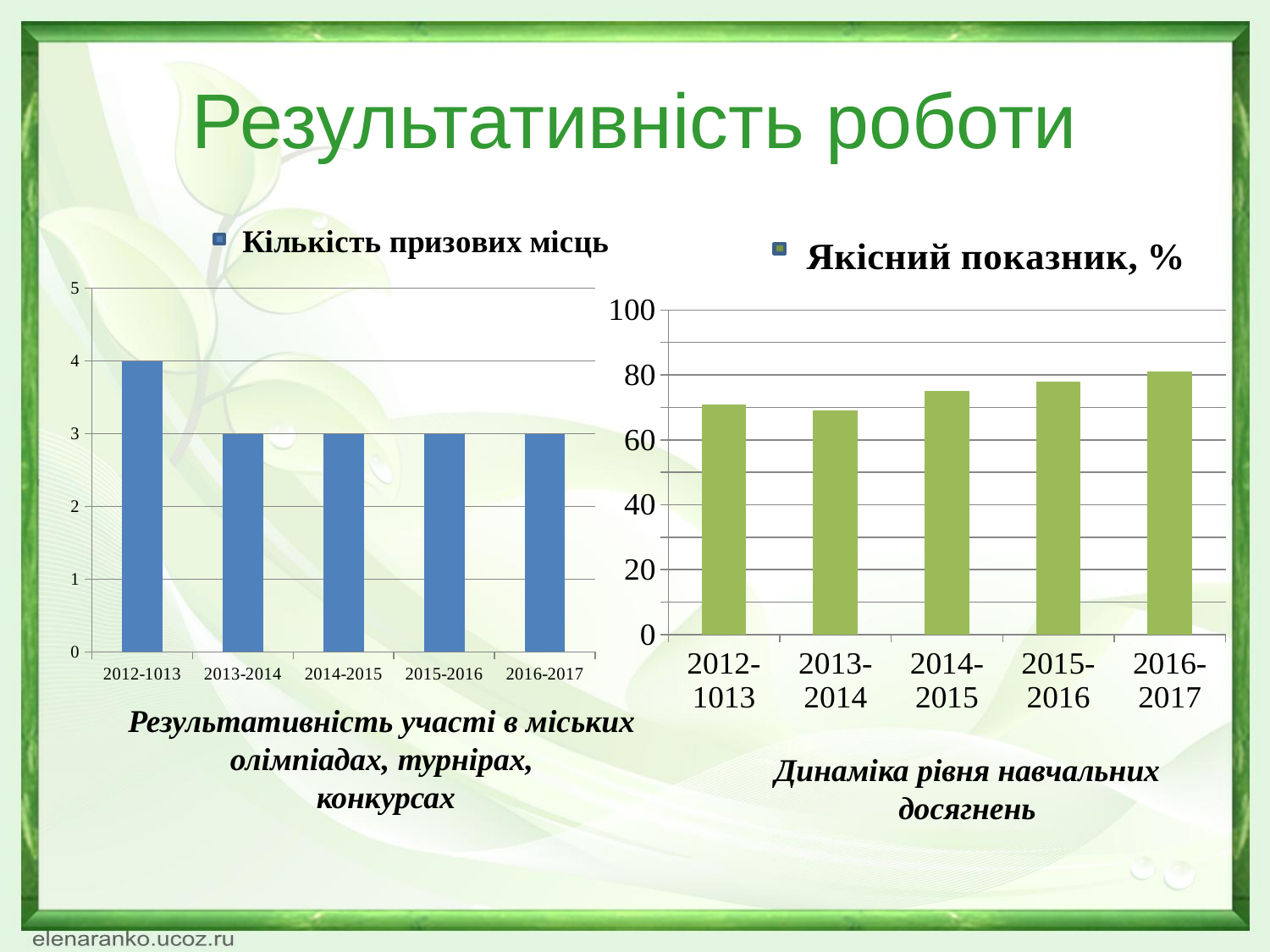
On the left chart (Кількість призових місць), what is the difference between the values for 2012-1013 and 2013-2014? 1 On the left chart (Кількість призових місць), what is the value for 2012-1013? 4 On the right chart (Якісний показник, %), which category has the highest value? 2016-2017 What type of chart is the left chart (Кількість призових місць)? bar chart What is the caption written below the right chart? Динаміка рівня навчальних досягнень On the right chart (Якісний показник, %), how many series does the legend list? 1 On the right chart (Якісний показник, %), is the value for 2012-1013 greater or less than 60? greater On the left chart (Кількість призових місць), what is the value for 2015-2016? 3 On the right chart (Якісний показник, %), which is larger, the value for 2013-2014 or the value for 2014-2015? 2014-2015 On the left chart (Кількість призових місць), which category has the highest value? 2012-1013 On the left chart (Кількість призових місць), how many categories are shown on the x axis? 5 On the right chart (Якісний показник, %), is the value for 2013-2014 greater or less than 80? less